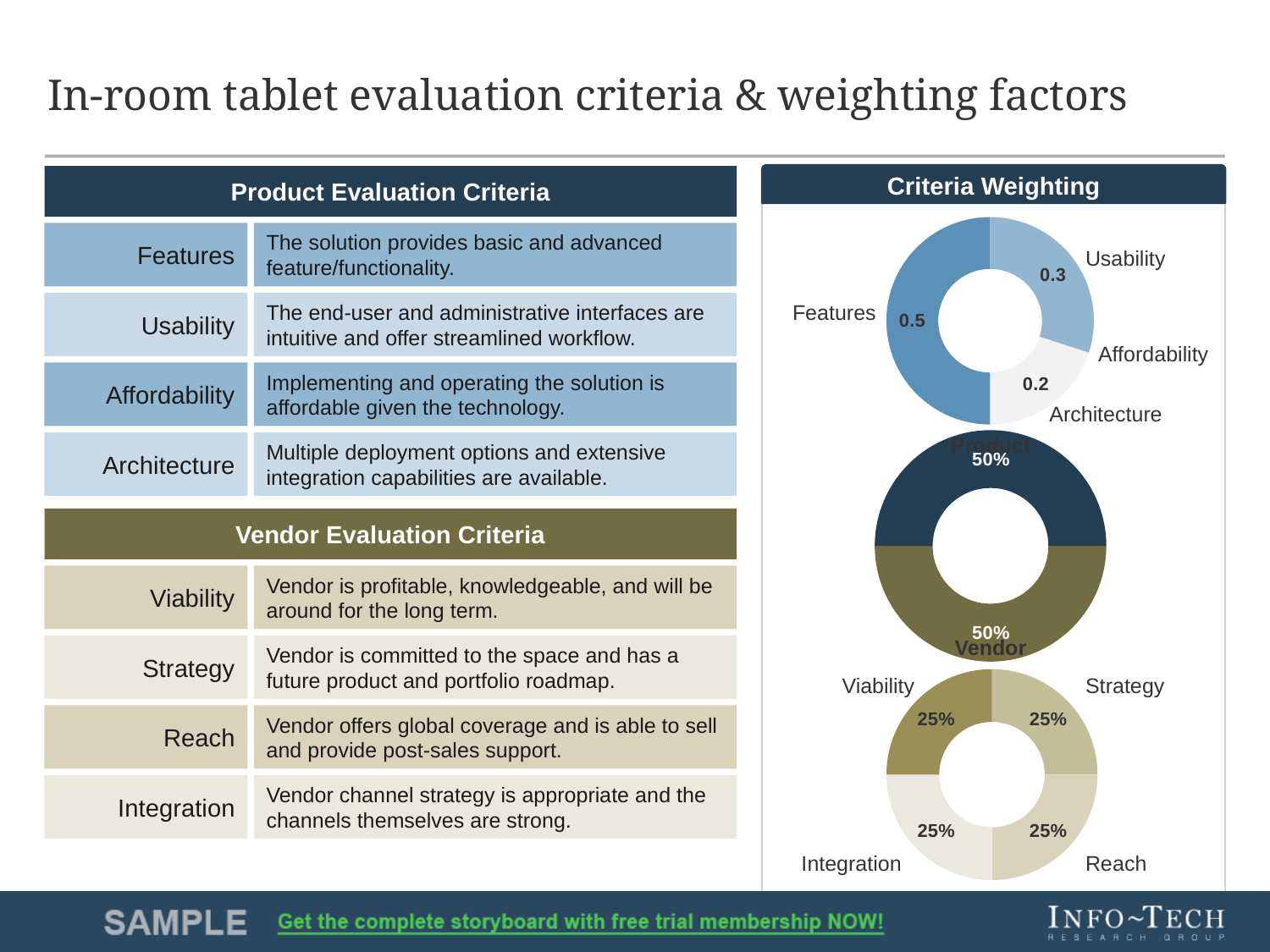
In the bottom donut chart under Criteria Weighting, what is the share for Viability? 25% In the bottom donut chart under Criteria Weighting, what is the share for Reach? 25% What type of chart is used in the Criteria Weighting panel? Donut chart In the top donut chart under Criteria Weighting, what is the difference between the weightings for Features and Usability? 0.2 In the top donut chart under Criteria Weighting, what is the weighting for Features? 0.5 In the top donut chart under Criteria Weighting, which criterion has the highest weighting? Features In the middle donut chart under Criteria Weighting, what share is given to Product? 50% In the middle donut chart under Criteria Weighting, what share is given to Vendor? 50% In the top donut chart under Criteria Weighting, which is weighted more heavily, Features or Usability? Features How many segments does the bottom donut chart under Criteria Weighting have? 4 How many segments does the middle donut chart under Criteria Weighting have? 2 In the top donut chart under Criteria Weighting, what is the weighting for Usability? 0.3